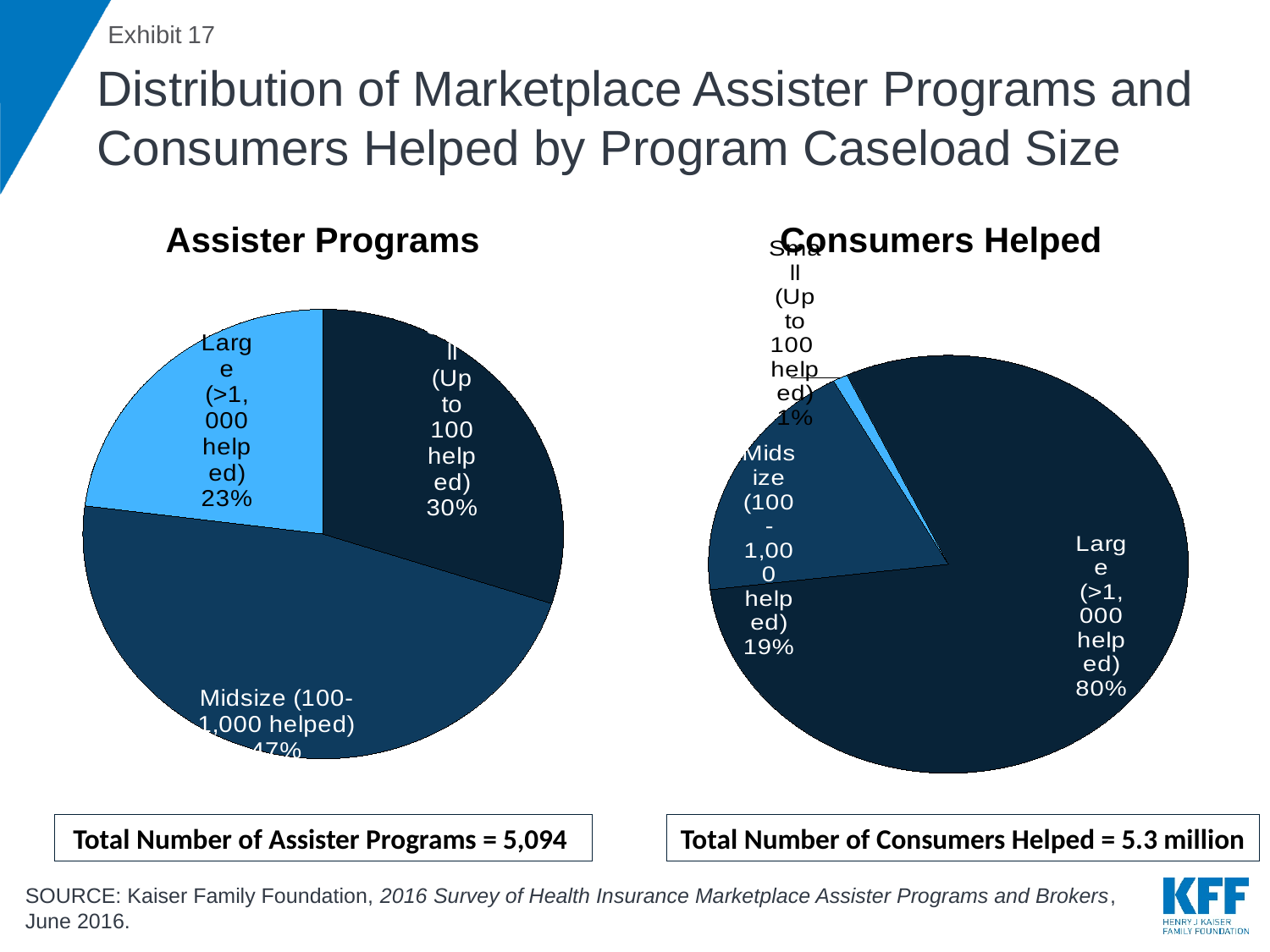
In the Assister Programs pie chart, which caseload size category has the largest share? Midsize (100-1,000 helped) In the Consumers Helped pie chart, what share of consumers were helped by Small (Up to 100 helped) programs? 1% In the Consumers Helped pie chart, what share of consumers were helped by Midsize (100-1,000 helped) programs? 19% What type of chart is used on this slide? Pie chart In the Assister Programs pie chart, what is the difference in percentage points between the Midsize and Large shares? 24 percentage points In the Assister Programs pie chart, what share of programs are Small (Up to 100 helped)? 30% In the Consumers Helped pie chart, which caseload size category has the smallest share? Small (Up to 100 helped) In the Consumers Helped pie chart, what is the difference in percentage points between the Large and Midsize shares? 61 percentage points In the Assister Programs pie chart, what share of programs are Midsize (100-1,000 helped)? 47% In the Assister Programs pie chart, what share of programs are Large (>1,000 helped)? 23% In the Consumers Helped pie chart, what share of consumers were helped by Large (>1,000 helped) programs? 80% How many slices does the Consumers Helped pie chart have? 3